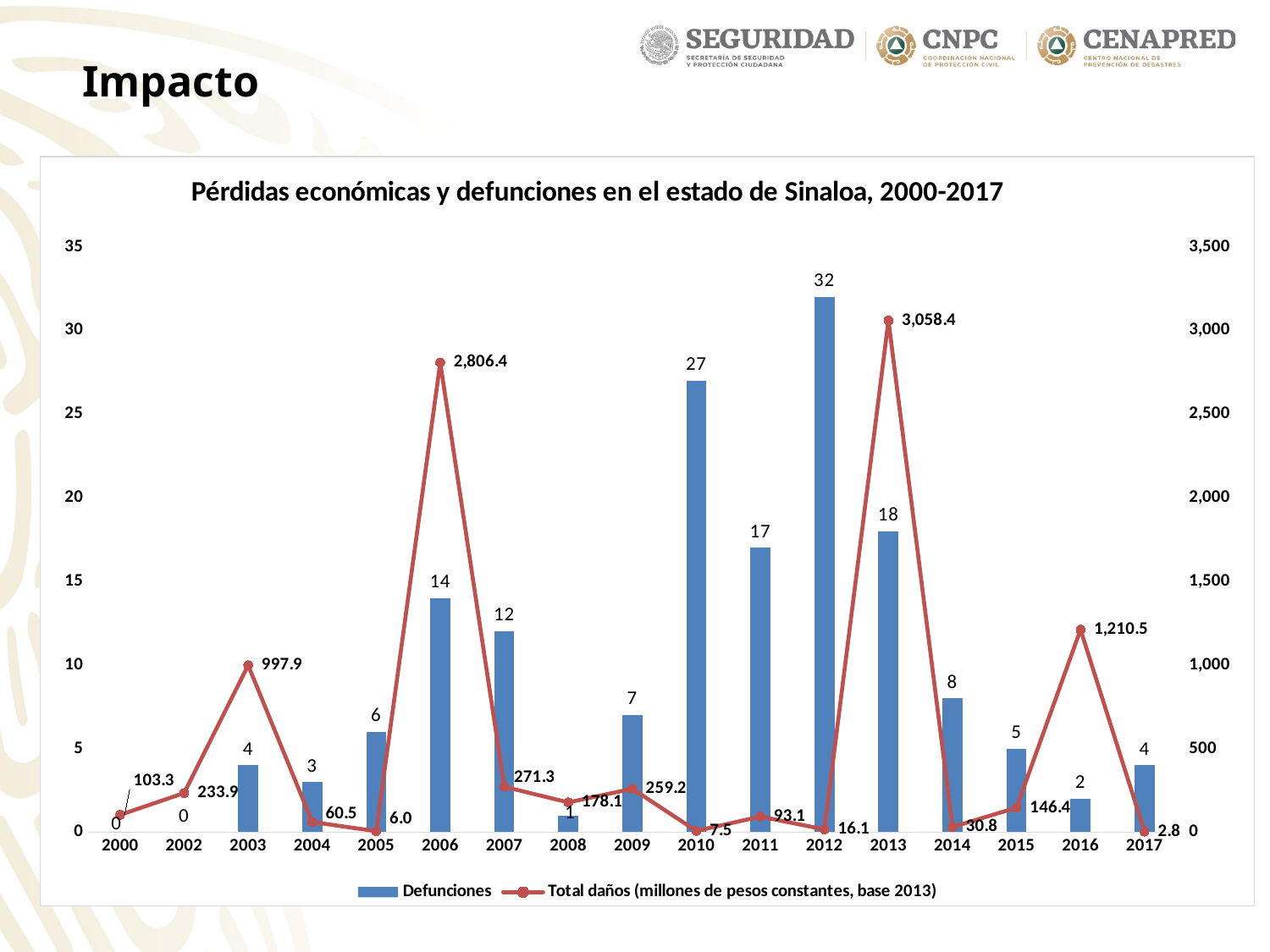
What kind of chart is this? Combined bar and line chart Which year has the highest value of Total daños? 2013 What is the value of Total daños in 2006? 2,806.4 Which is larger, the Total daños in 2016 or in 2003? 2016 How many series does the legend list? 2 What is the value of Total daños in 2013? 3,058.4 Which year has the highest number of Defunciones? 2012 How many years are shown on the x axis? 17 What is the difference in Defunciones between 2010 and 2011? 10 What is the title of the chart? Pérdidas económicas y defunciones en el estado de Sinaloa, 2000-2017 Which year has the lowest value of Total daños? 2017 What is the number of Defunciones in 2012? 32